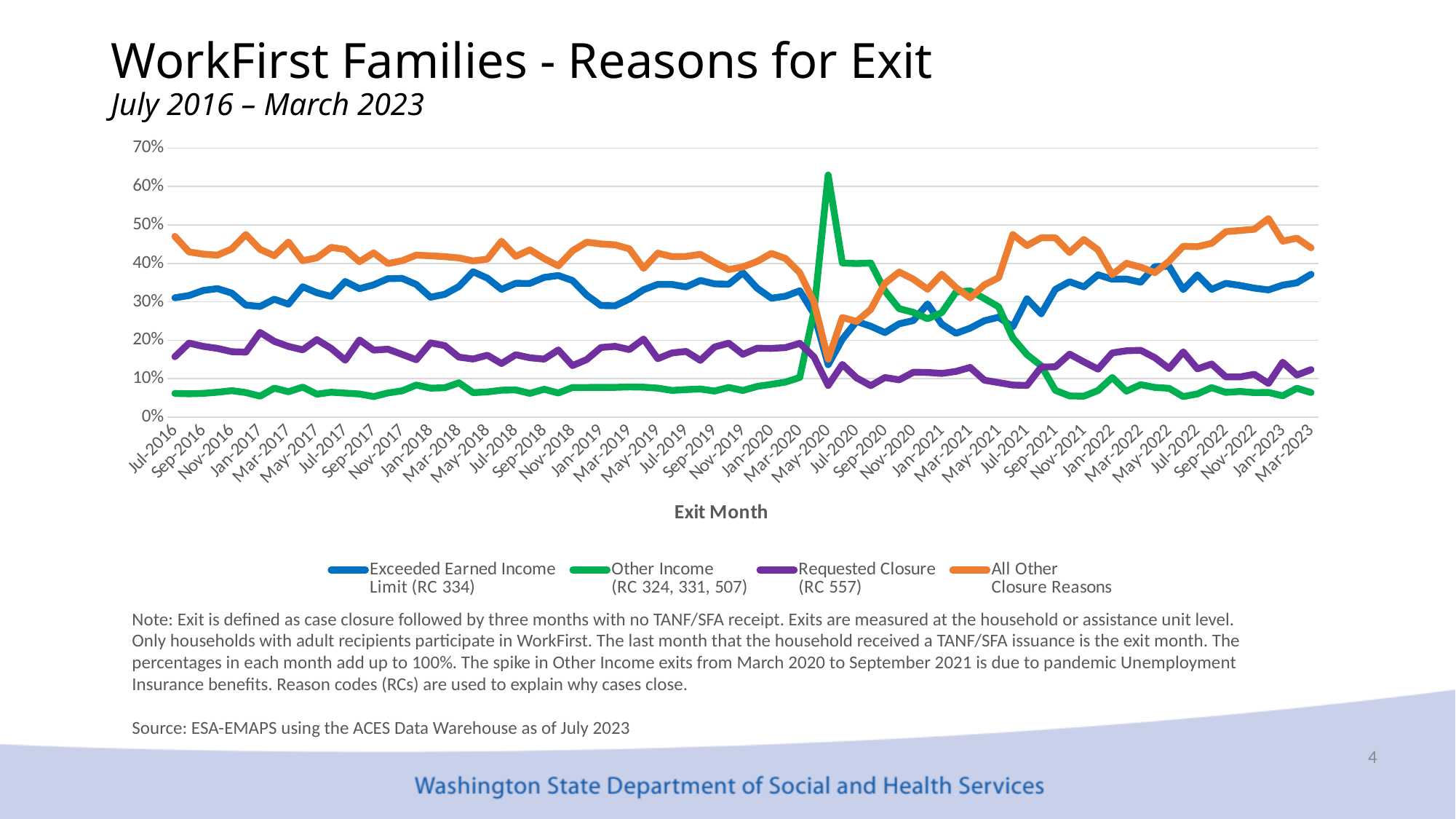
Which series reaches the highest value anywhere on the chart? Other Income (RC 324, 331, 507) How many series does the legend list? 4 What kind of chart is shown on the slide? Line chart What is the title of the x axis? Exit Month In Jul-2016, which is larger: All Other Closure Reasons or Exceeded Earned Income Limit (RC 334)? All Other Closure Reasons Which series has the lowest value in Jul-2016? Other Income (RC 324, 331, 507) Does the Other Income (RC 324, 331, 507) line rise or fall from May-2020 to Sep-2021? Fall Is the value for Other Income (RC 324, 331, 507) in Jul-2016 greater or less than 10%? less In May-2020, which is larger: Other Income (RC 324, 331, 507) or All Other Closure Reasons? Other Income (RC 324, 331, 507) Is the value for Requested Closure (RC 557) in Jul-2016 greater or less than 20%? less Is the value for Other Income (RC 324, 331, 507) in May-2020 greater or less than 60%? greater